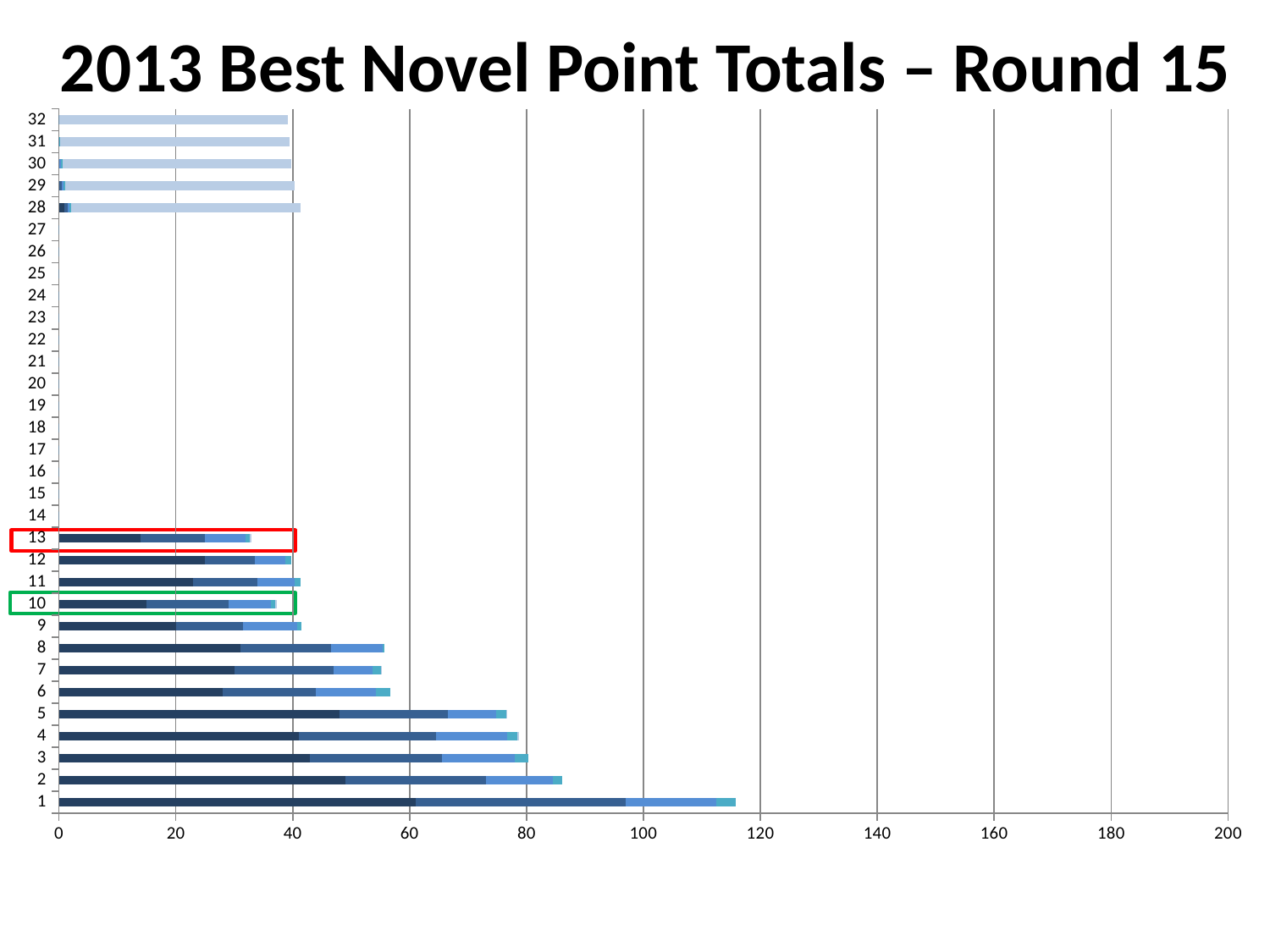
Is the total value for category 13 greater or less than 40? less Is the total value for category 8 greater or less than 60? less Is the total value for category 2 greater or less than 80? greater How many categories are listed on the vertical axis of the chart? 32 What is the title of the chart? 2013 Best Novel Point Totals – Round 15 What kind of chart is shown on the slide? bar chart Which category label is outlined with a red box on the chart? 13 Which category has the longest bar in the chart? 1 Which has the larger total, category 8 or category 13? 8 Which has the larger total, category 1 or category 2? 1